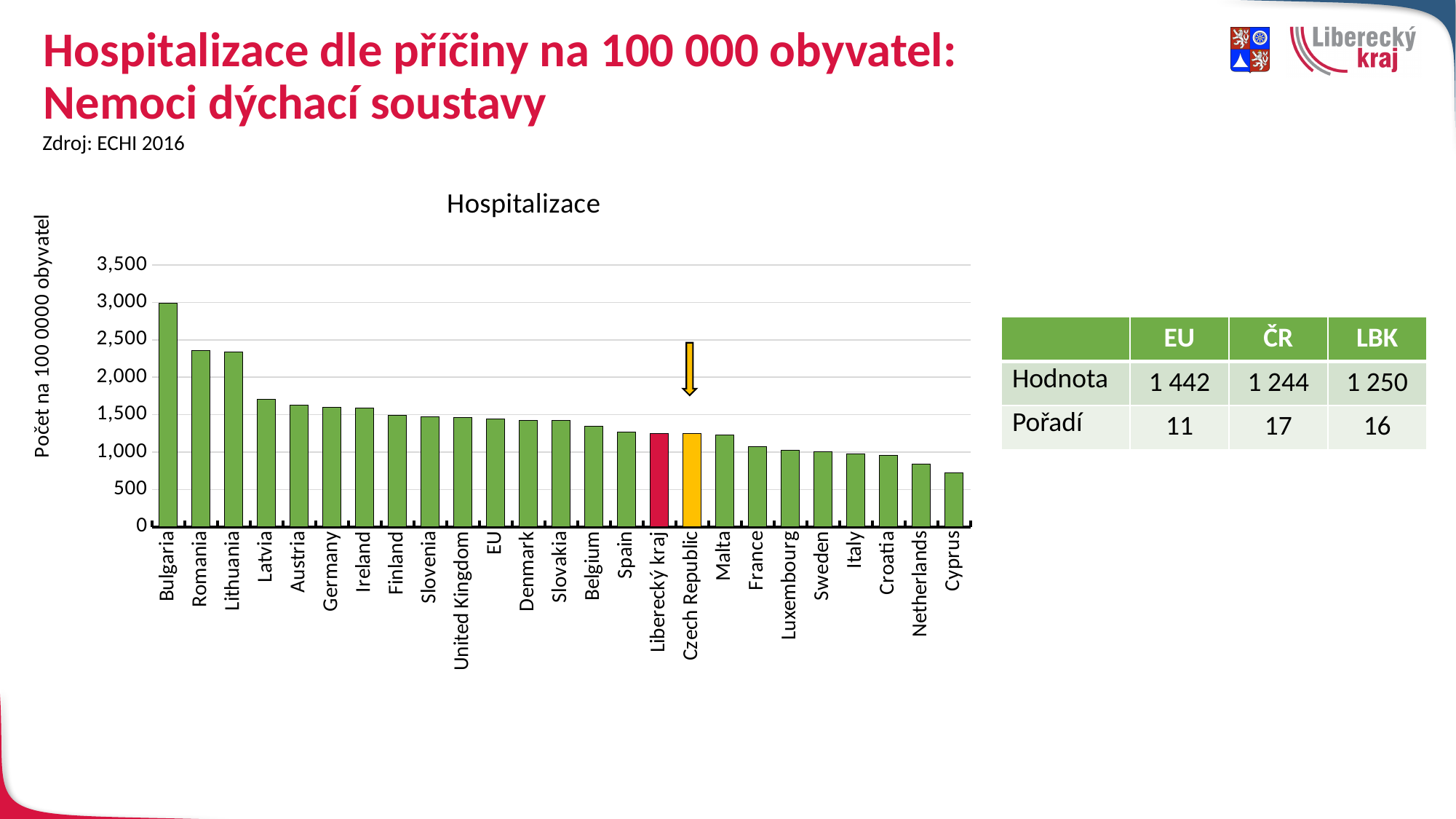
Do the values rise or fall from left to right along the x axis? fall How many categories (bars) are shown in the chart? 25 Which is larger, the value for the EU or the value for the Czech Republic? EU What is the hospitalization value for the Czech Republic (ČR) according to the table? 1 244 Is the value for Netherlands greater or less than 1,000? less What type of chart is shown on the slide? bar chart Which country has the lowest hospitalization rate in the chart? Cyprus What is the difference between the EU value and the ČR value in the table? 198 Is the value for Bulgaria greater or less than 2,500? greater What is the hospitalization value for Liberecký kraj (LBK) according to the table? 1 250 What is the hospitalization value for the EU according to the table? 1 442 Which country has the highest hospitalization rate in the chart? Bulgaria